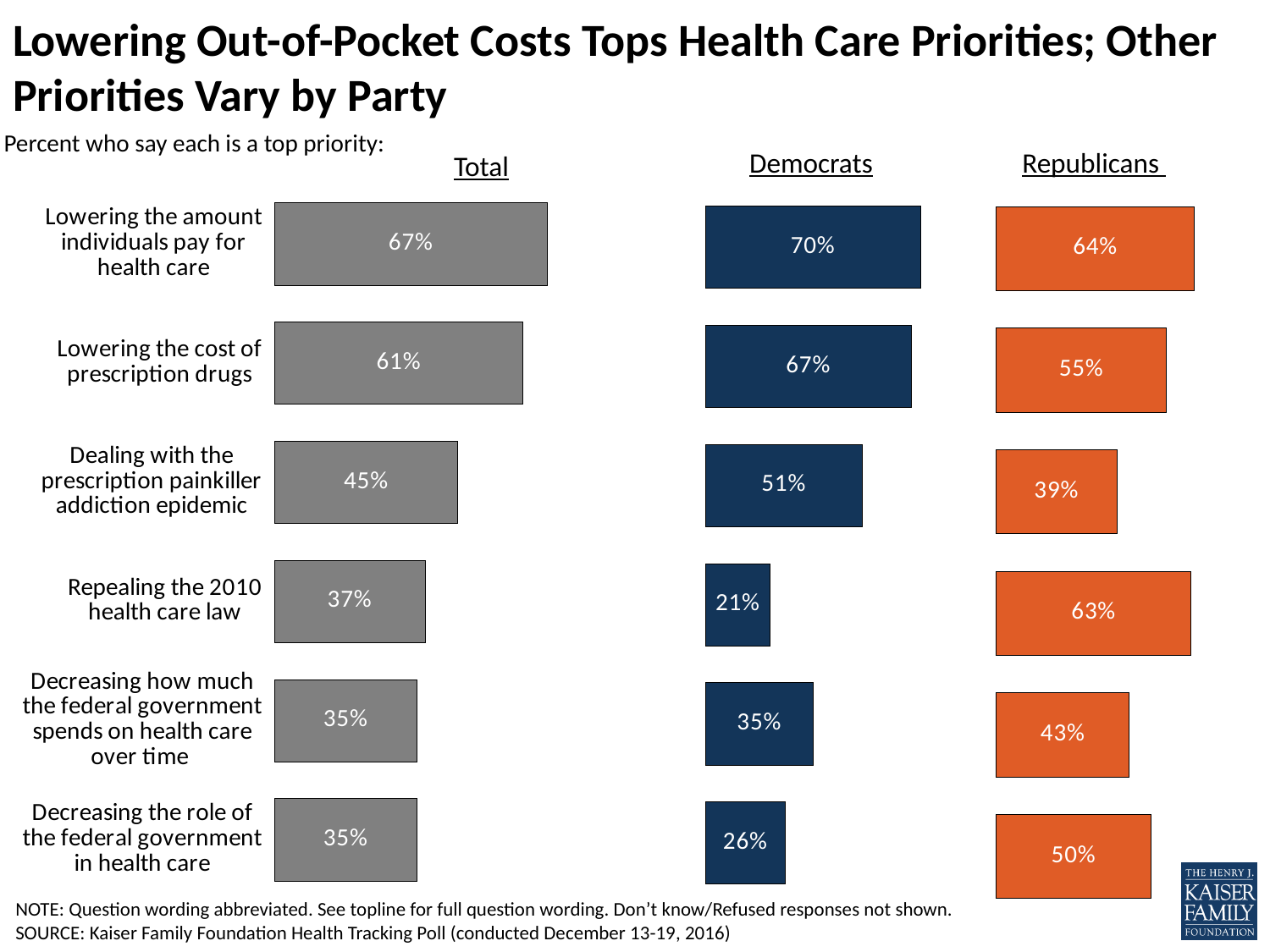
What is the difference between Republicans and Democrats on repealing the 2010 health care law? 42 percentage points What percent of the Total say lowering the amount individuals pay for health care is a top priority? 67% What percent of Republicans say repealing the 2010 health care law is a top priority? 63% Which priority has the lowest percentage among Republicans? Dealing with the prescription painkiller addiction epidemic How many health care priorities are listed on the slide? 6 What kind of chart is shown on the slide? Bar chart Who is more likely to say decreasing the role of the federal government in health care is a top priority, Democrats or Republicans? Republicans Which priority has the lowest percentage among Democrats? Repealing the 2010 health care law Which priority has the highest percentage among Democrats? Lowering the amount individuals pay for health care What percent of Democrats say lowering the cost of prescription drugs is a top priority? 67% What colour are the bars for Republicans? Orange How many groups (columns) are shown on the slide? 3